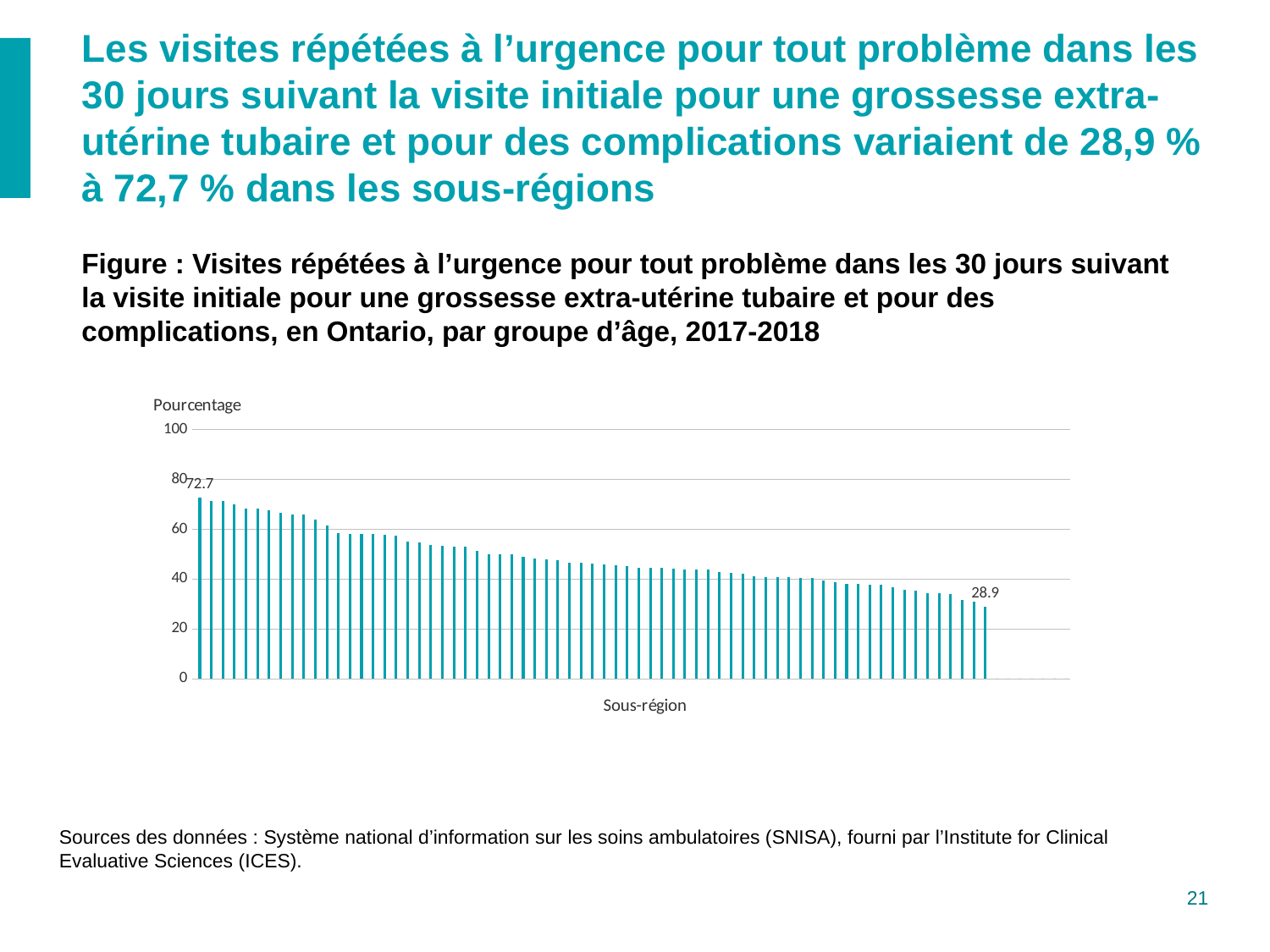
Is the value of the leftmost bar greater or less than 80? less Is the value of the rightmost bar greater or less than 40? less What is the difference between the highest value (72.7) and the lowest value (28.9) on the chart? 43.8 Is the value of the leftmost bar greater or less than 60? greater What kind of chart is shown on the slide? bar chart Do the bar values rise or fall from left to right along the x axis? fall What is the label of the vertical axis of the chart? Pourcentage What is the label of the horizontal axis of the chart? Sous-région Which bar is larger, the leftmost bar or the rightmost bar? the leftmost bar What is the highest value shown on the chart? 72.7 What is the lowest value shown on the chart? 28.9